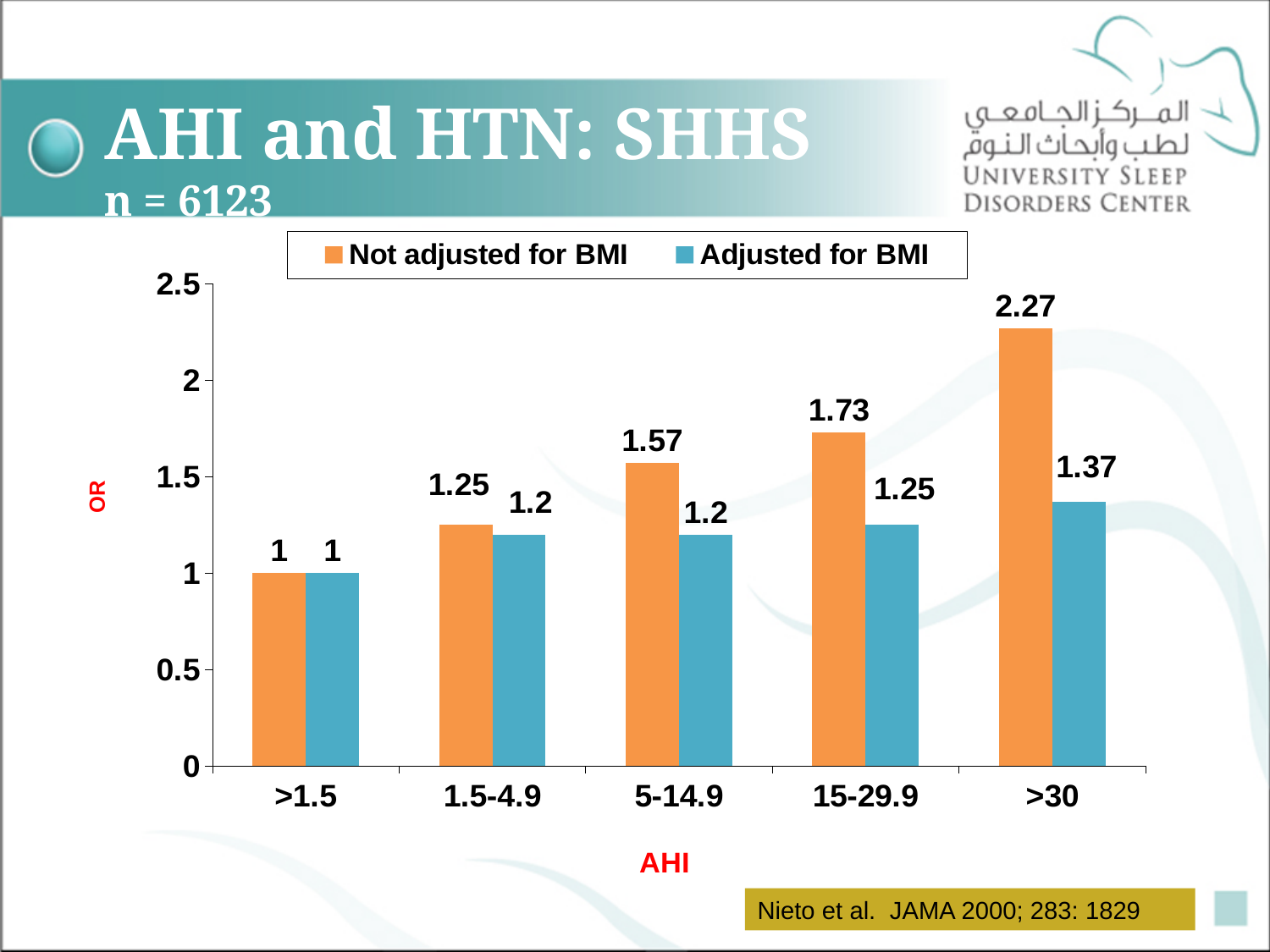
What is the 'Adjusted for BMI' value for the AHI category 5-14.9? 1.2 What is the 'Adjusted for BMI' odds ratio for the AHI category 15-29.9? 1.25 Do the 'Not adjusted for BMI' values rise or fall as AHI increases along the x axis? Rise What is the 'Not adjusted for BMI' odds ratio for the AHI category >30? 2.27 What is the difference between the 'Not adjusted for BMI' values for AHI 15-29.9 and AHI 5-14.9? 0.16 Which AHI category has the lowest 'Adjusted for BMI' odds ratio? >1.5 Which AHI category has the highest 'Not adjusted for BMI' odds ratio? >30 What kind of chart is shown on the slide? Bar chart How many AHI categories are shown on the x axis? 5 How many series does the legend list? 2 What is the difference between the 'Not adjusted for BMI' and 'Adjusted for BMI' values for the AHI category >30? 0.9 For the AHI category 15-29.9, which is larger: the 'Not adjusted for BMI' value or the 'Adjusted for BMI' value? Not adjusted for BMI